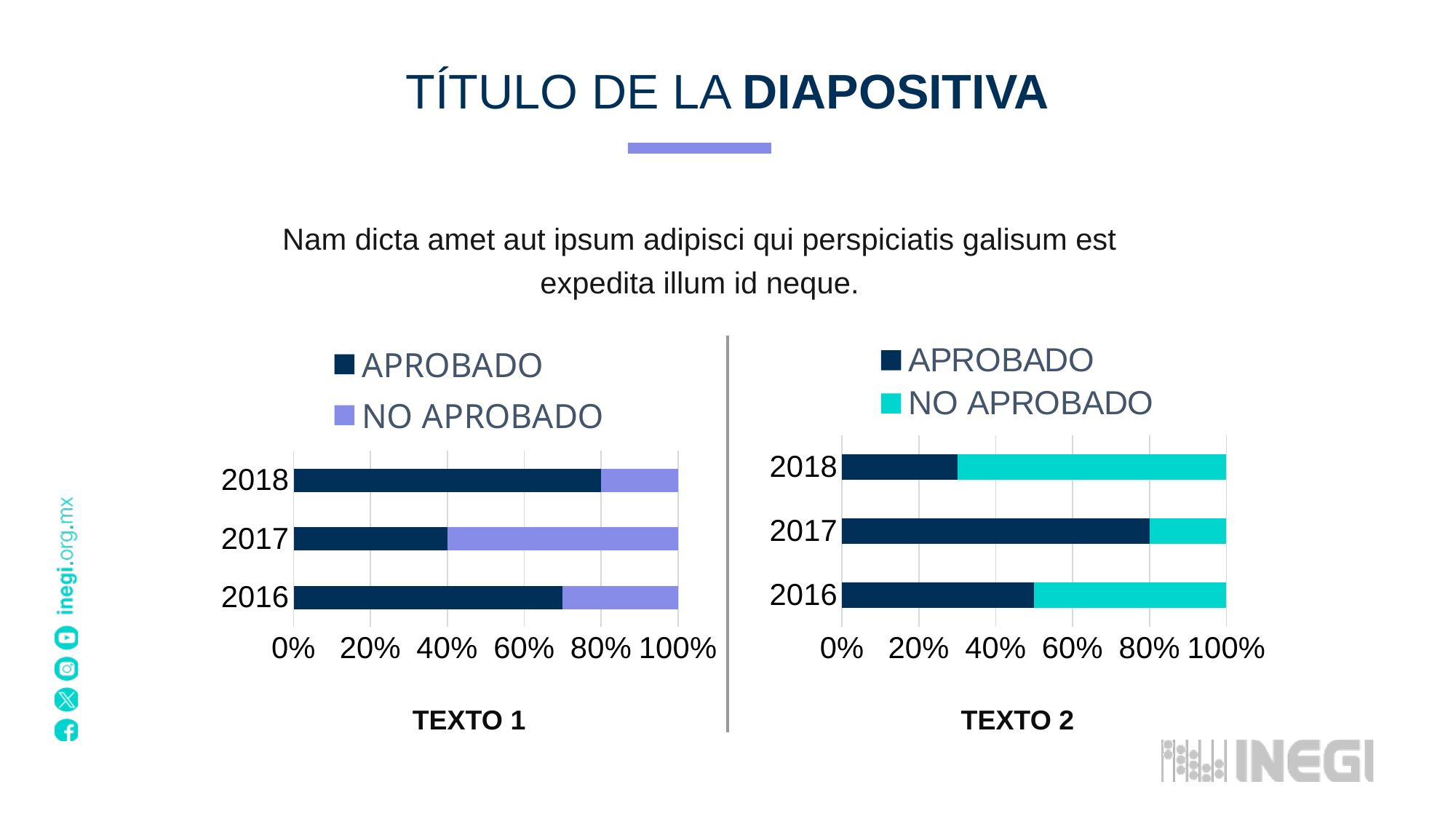
In the right chart (TEXTO 2), which year has the lowest APROBADO share? 2018 In the right chart (TEXTO 2), is the NO APROBADO value for 2017 greater or less than 40%? less In the right chart (TEXTO 2), is the APROBADO value for 2018 greater or less than 40%? less What colour represents NO APROBADO in the right chart (TEXTO 2)? turquoise In the left chart (TEXTO 1), which year has the lowest APROBADO share? 2017 How many years are shown on the left chart (TEXTO 1)? 3 In the left chart (TEXTO 1), is the APROBADO value for 2016 greater or less than 60%? greater What kind of chart is the left chart (TEXTO 1)? bar chart How many series does the legend of the right chart (TEXTO 2) list? 2 In the left chart (TEXTO 1), which is larger for 2017: APROBADO or NO APROBADO? NO APROBADO In the left chart (TEXTO 1), which year has the highest APROBADO share? 2018 In the right chart (TEXTO 2), which year has the highest APROBADO share? 2017